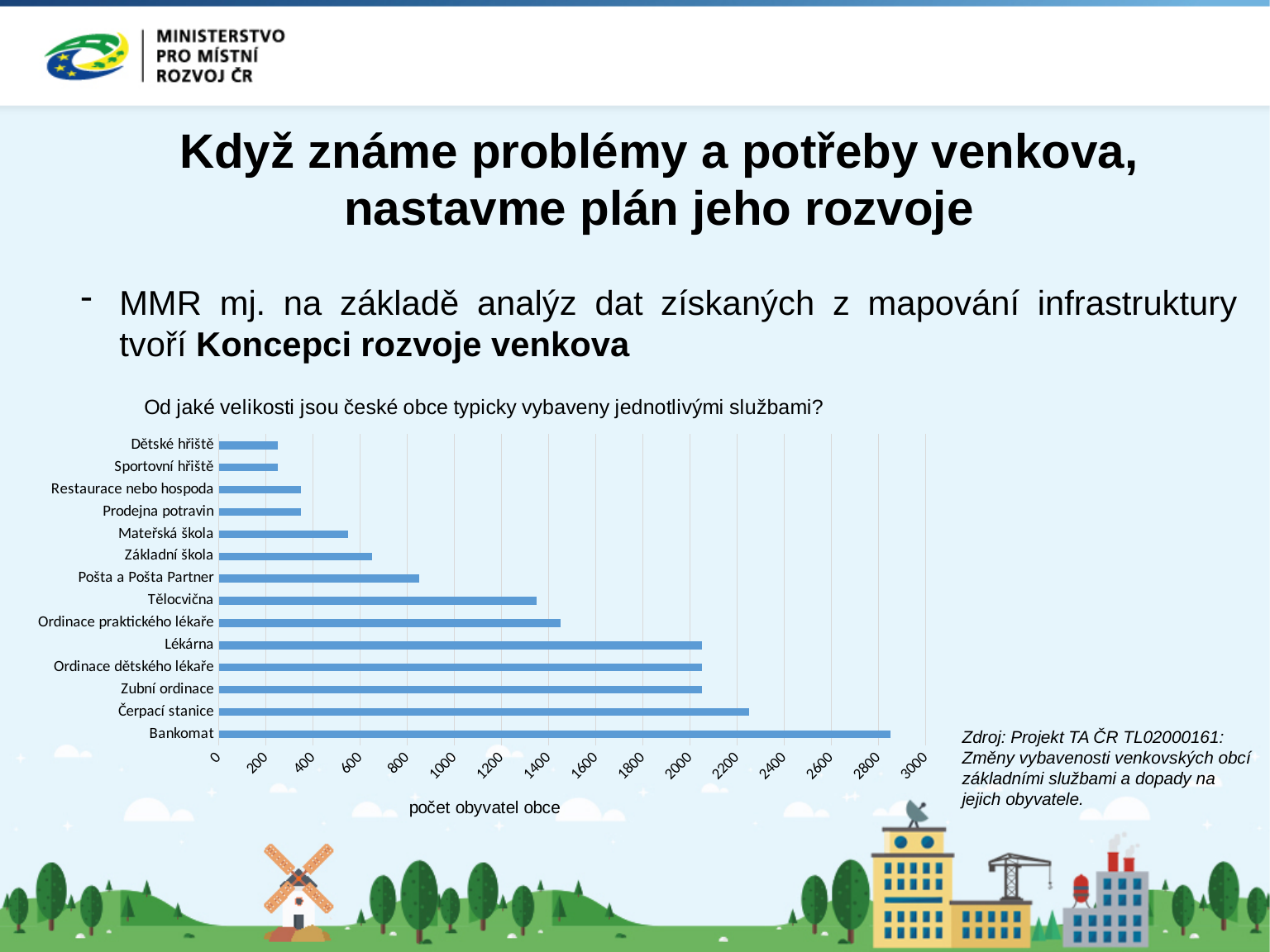
Is the value for Tělocvična greater or less than 1200? greater Which has the larger value, Lékárna or Ordinace praktického lékaře? Lékárna Which service has the highest value in the chart? Bankomat Is the value for Mateřská škola greater or less than 800? less Which has the larger value, Bankomat or Čerpací stanice? Bankomat What kind of chart is shown on the slide? bar chart Is the value for Bankomat greater or less than 2600? greater What is the label of the horizontal axis of the chart? počet obyvatel obce How many categories (services) are plotted in the chart? 14 Which has the larger value, Tělocvična or Pošta a Pošta Partner? Tělocvična